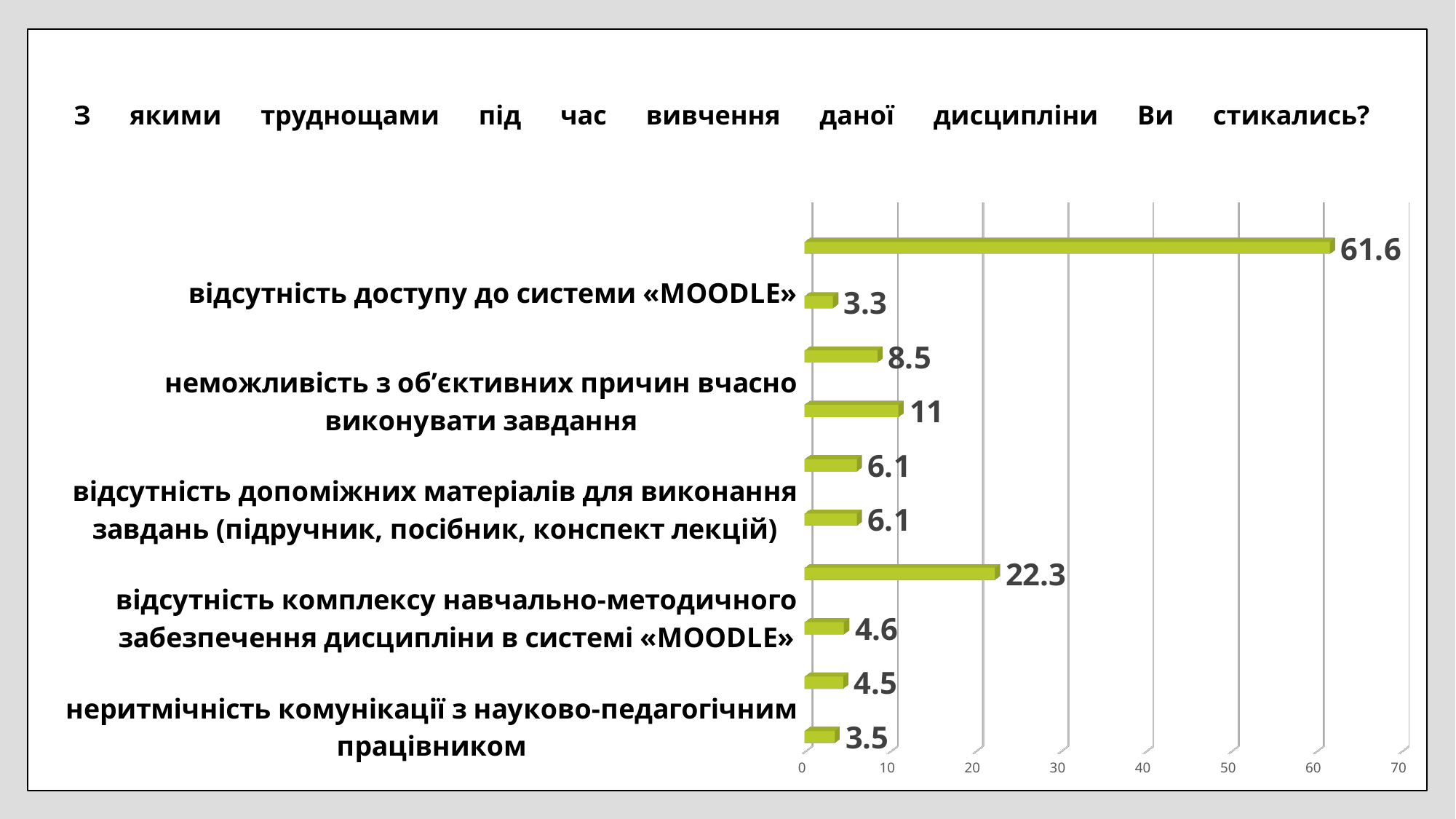
What is the highest value shown in the chart? 61.6 What is the second-highest value shown in the chart? 22.3 Which is larger, the bar labelled 8.5 or the bar labelled 4.6? 8.5 What is the value of the bar next to the label «відсутність доступу до системи «MOODLE»»? 3.3 What is the maximum value shown on the horizontal axis? 70 What is the lowest value shown in the chart? 3.3 What is the difference between the bar labelled 22.3 and the bar labelled 11? 11.3 How many bars are plotted in the chart? 10 What is the difference between the highest value (61.6) and the second-highest value (22.3)? 39.3 How many bars have the value 6.1? 2 Is the value of the longest bar greater or less than 60? greater What type of chart is shown on the slide? bar chart